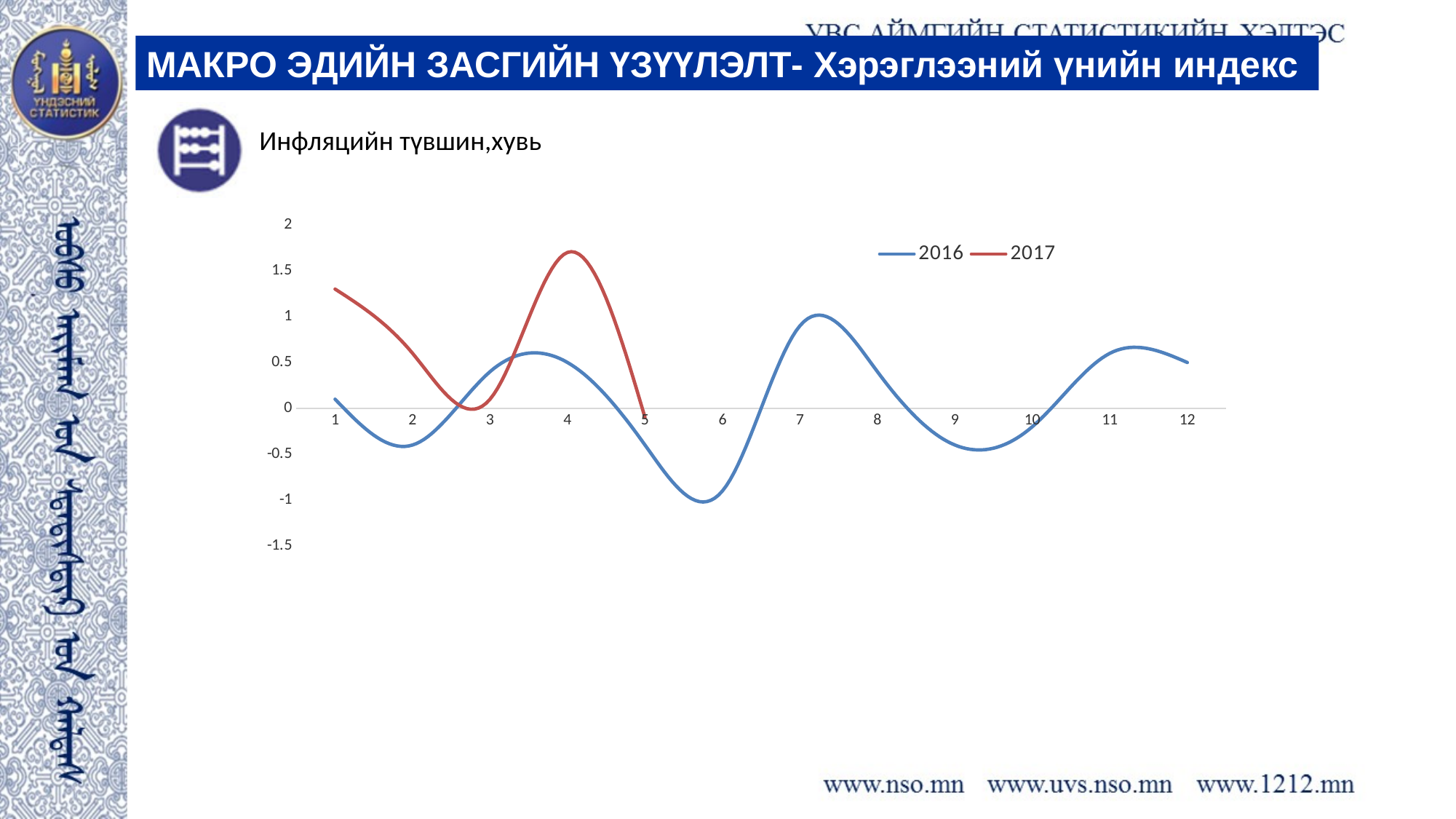
Is the 2017 value at point 4 greater or less than 1.5? greater What kind of chart is shown on the slide? line chart Is the 2016 value at point 6 greater or less than -0.5? less Is the 2016 value at point 7 greater or less than 0.5? greater How many points are labelled along the x axis? 12 At point 4, which series has the larger value, 2016 or 2017? 2017 At which x-axis point does the 2017 series reach its highest value? 4 How many series does the legend list? 2 Which series does the legend list besides 2016? 2017 At point 1, which series has the larger value, 2016 or 2017? 2017 At which x-axis point does the 2016 series reach its lowest value? 6